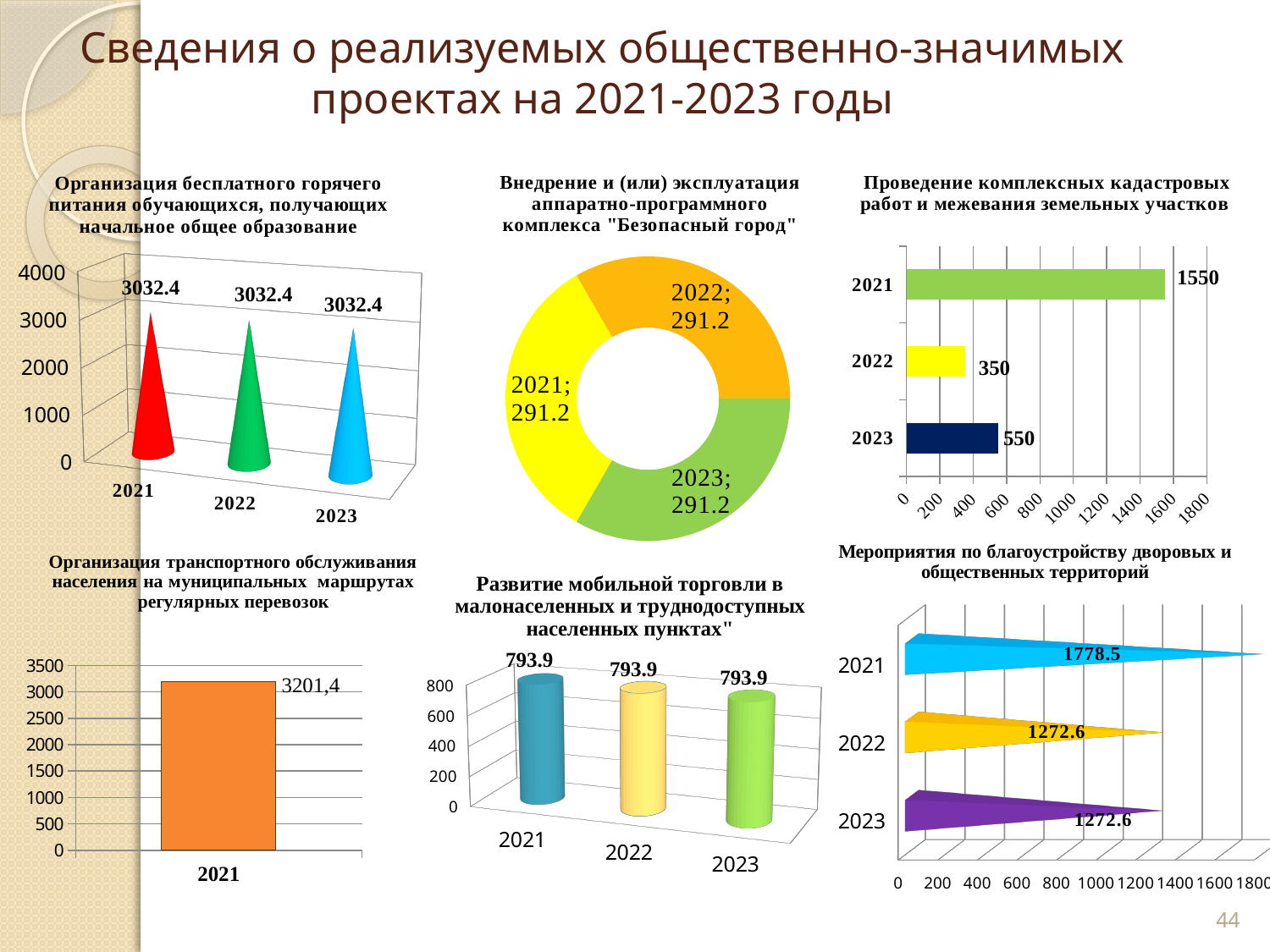
In the chart titled "Проведение комплексных кадастровых работ и межевания земельных участков", which year has the lowest value? 2022 In the chart titled "Развитие мобильной торговли в малонаселенных и труднодоступных населенных пунктах", what is the value for 2023? 793.9 In the chart titled "Внедрение и (или) эксплуатация аппаратно-программного комплекса "Безопасный город"", what is the value for 2022? 291.2 In the chart titled "Мероприятия по благоустройству дворовых и общественных территорий", what is the difference between the values for 2021 and 2022? 505.9 In the chart titled "Организация транспортного обслуживания населения на муниципальных маршрутах регулярных перевозок", what is the value for 2021? 3201,4 In the chart titled "Проведение комплексных кадастровых работ и межевания земельных участков", what is the value for 2021? 1550 In the chart titled "Мероприятия по благоустройству дворовых и общественных территорий", what is the value for 2021? 1778.5 In the chart titled "Мероприятия по благоустройству дворовых и общественных территорий", which year has the highest value? 2021 How many years are shown in the chart titled "Проведение комплексных кадастровых работ и межевания земельных участков"? 3 In the chart titled "Организация бесплатного горячего питания обучающихся, получающих начальное общее образование", what is the value for 2022? 3032.4 What kind of chart is the one titled "Внедрение и (или) эксплуатация аппаратно-программного комплекса "Безопасный город""? Doughnut chart In the chart titled "Проведение комплексных кадастровых работ и межевания земельных участков", what is the difference between the values for 2021 and 2023? 1000